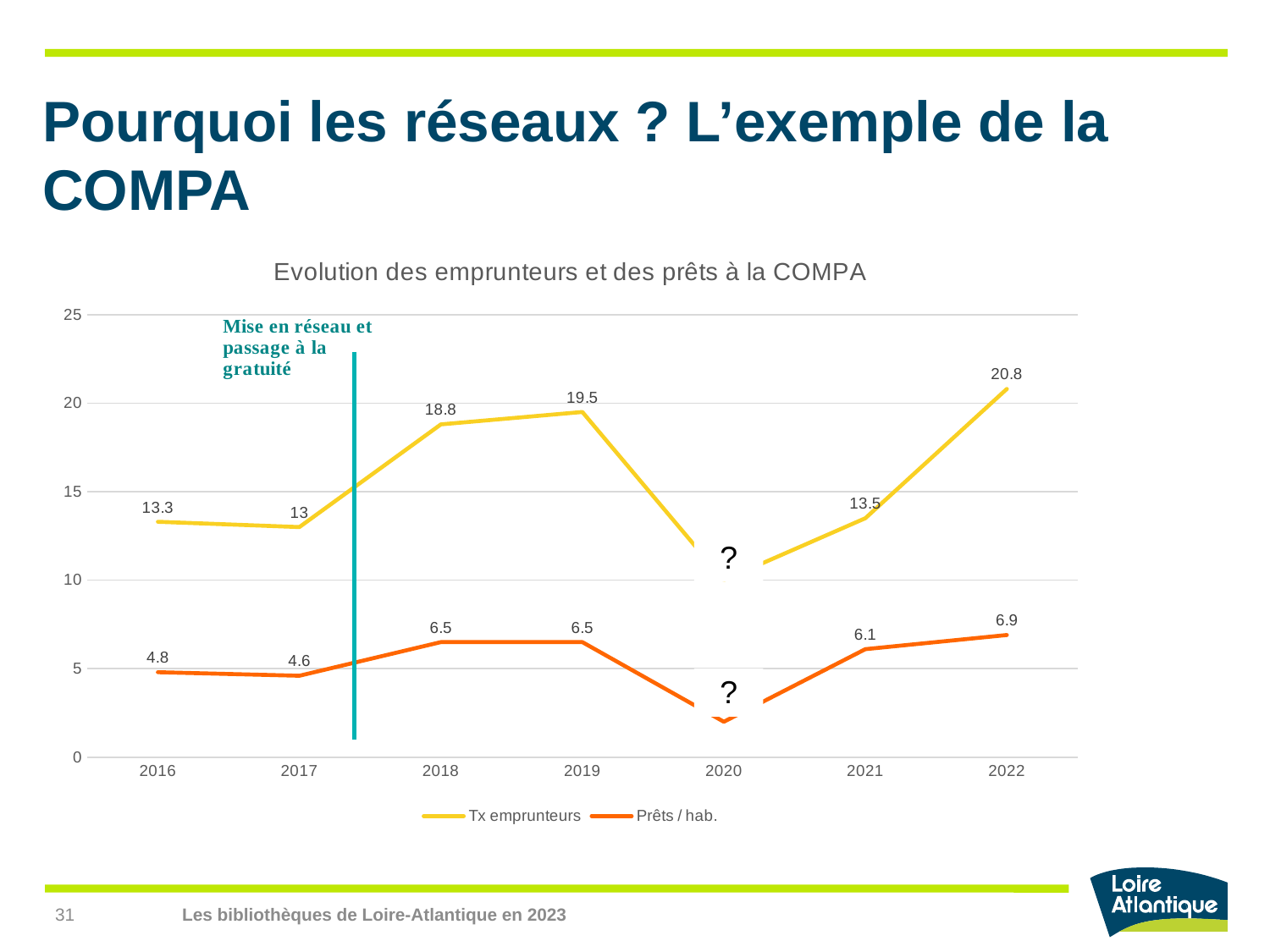
How many series does the legend list? 2 In which year is Tx emprunteurs highest? 2022 In which year is Prêts / hab. lowest among the labelled values? 2017 What is the title of the chart? Evolution des emprunteurs et des prêts à la COMPA What is the value of Tx emprunteurs in 2018? 18.8 What is the value of Prêts / hab. in 2022? 6.9 What is the value of Tx emprunteurs in 2016? 13.3 What kind of chart is shown on the slide? line chart Which is larger, Prêts / hab. in 2018 or in 2021? 2018 How many years are shown on the x axis? 7 Is the value for Tx emprunteurs in 2019 greater or less than 15? greater What is the difference between Tx emprunteurs in 2022 and in 2021? 7.3